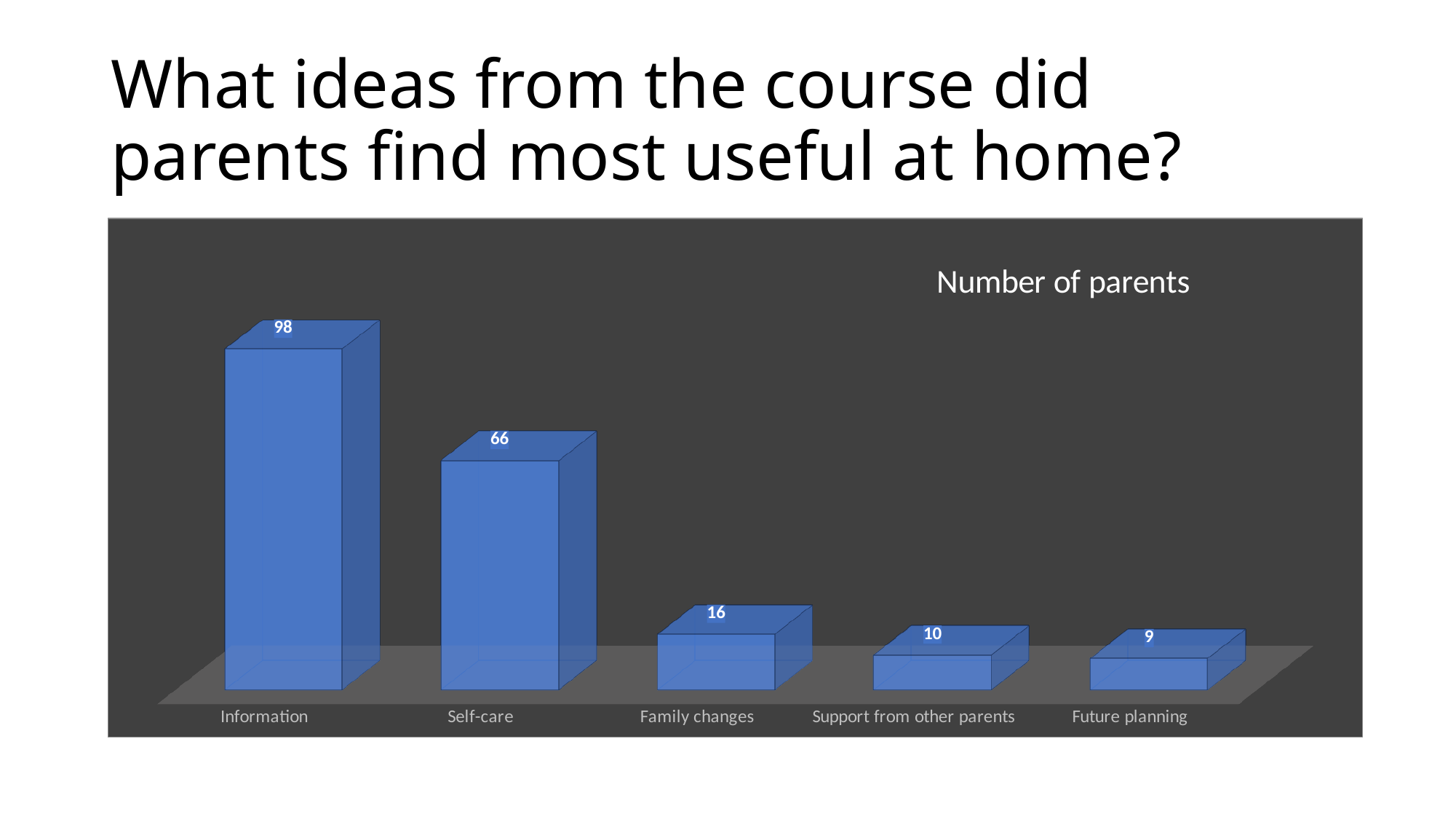
Which category has the lowest number of parents? Future planning What is the number of parents for Self-care? 66 What kind of chart is shown on the slide? Bar chart What is the difference between the number of parents for Information and Self-care? 32 How many categories are shown in the chart? 5 Which has more parents, Family changes or Support from other parents? Family changes What is the number of parents for Support from other parents? 10 What is the number of parents for Future planning? 9 Which category has the highest number of parents? Information What is the number of parents for Information? 98 What is the number of parents for Family changes? 16 What is the title shown on the chart? Number of parents